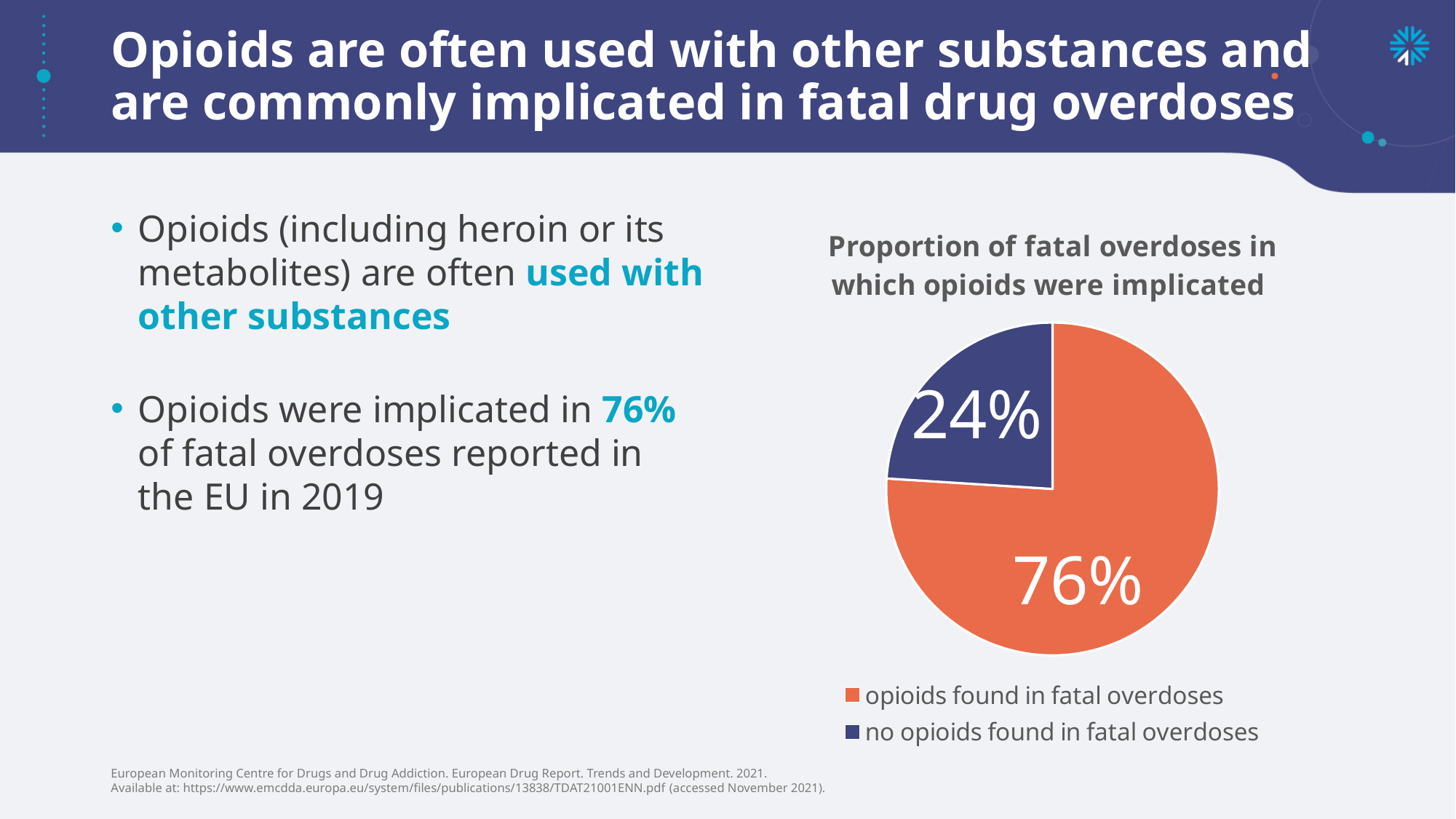
How many slices does the pie chart have? 2 Which slice of the pie is the largest? opioids found in fatal overdoses What share of fatal overdoses had no opioids found in them? 24% What is the title of the chart? Proportion of fatal overdoses in which opioids were implicated Which slice of the pie is the smallest? no opioids found in fatal overdoses What share of fatal overdoses had opioids found in them? 76% Which is larger: the share of fatal overdoses with opioids found or the share with no opioids found? opioids found in fatal overdoses What type of chart is shown on the slide? pie chart How many entries does the legend list? 2 What is the difference in percentage points between the 'opioids found in fatal overdoses' slice and the 'no opioids found in fatal overdoses' slice? 52 What colour is the 'no opioids found in fatal overdoses' slice? dark blue